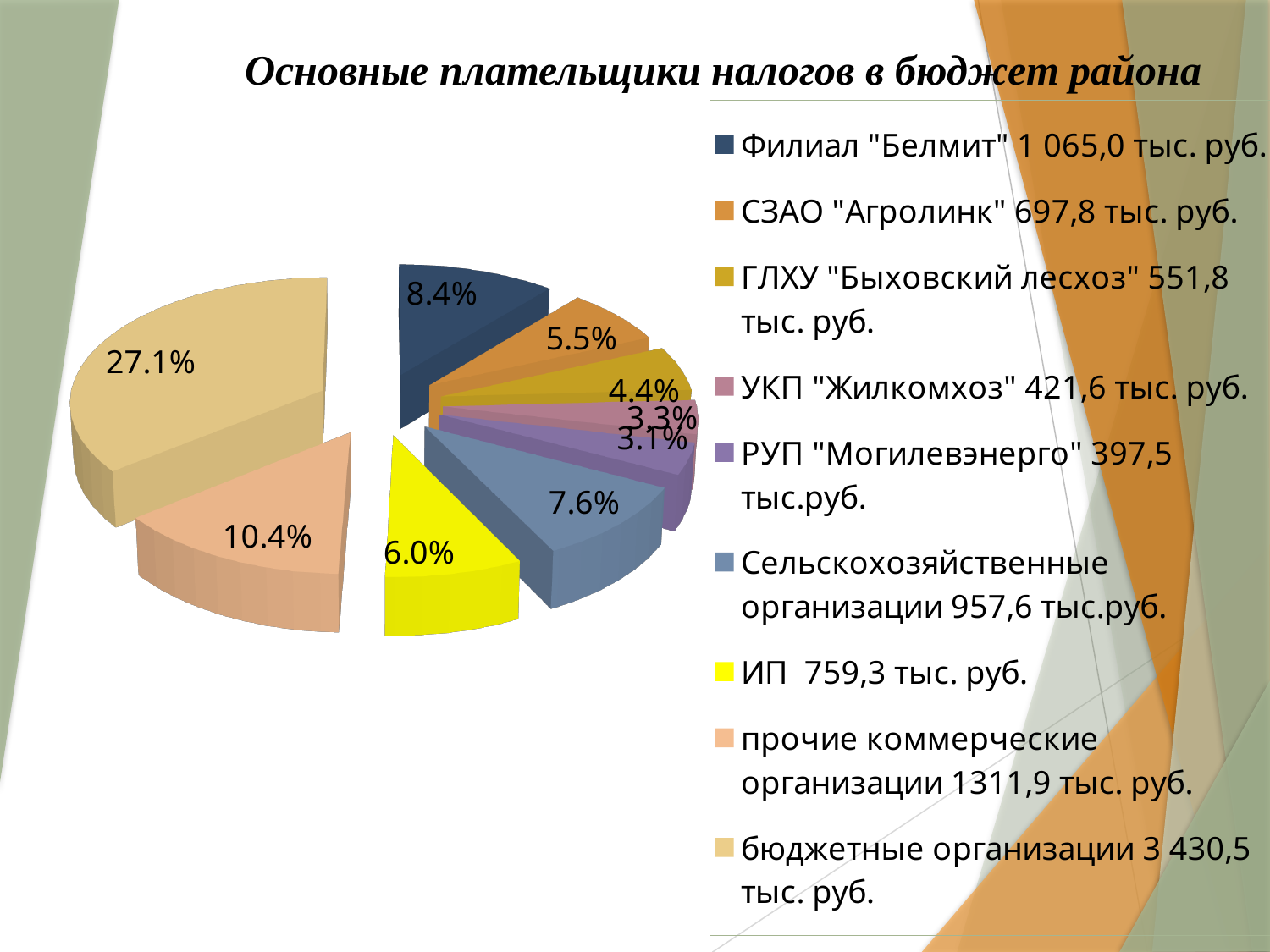
What percentage share is shown for ИП? 6.0% What is the title of the chart? Основные плательщики налогов в бюджет района How many entries does the legend list? 9 How many slices does the pie chart have? 9 Which is larger, the share for Сельскохозяйственные организации or the share for СЗАО "Агролинк"? Сельскохозяйственные организации What percentage share is shown for Филиал "Белмит"? 8.4% What kind of chart is shown on the slide? pie chart Which category has the largest slice of the pie? бюджетные организации According to the legend, what amount is listed for ГЛХУ "Быховский лесхоз"? 551,8 тыс. руб. What is the difference in percentage points between the share for бюджетные организации and the share for прочие коммерческие организации? 16.7 What percentage share is shown for бюджетные организации? 27.1% What percentage share is shown for прочие коммерческие организации? 10.4%